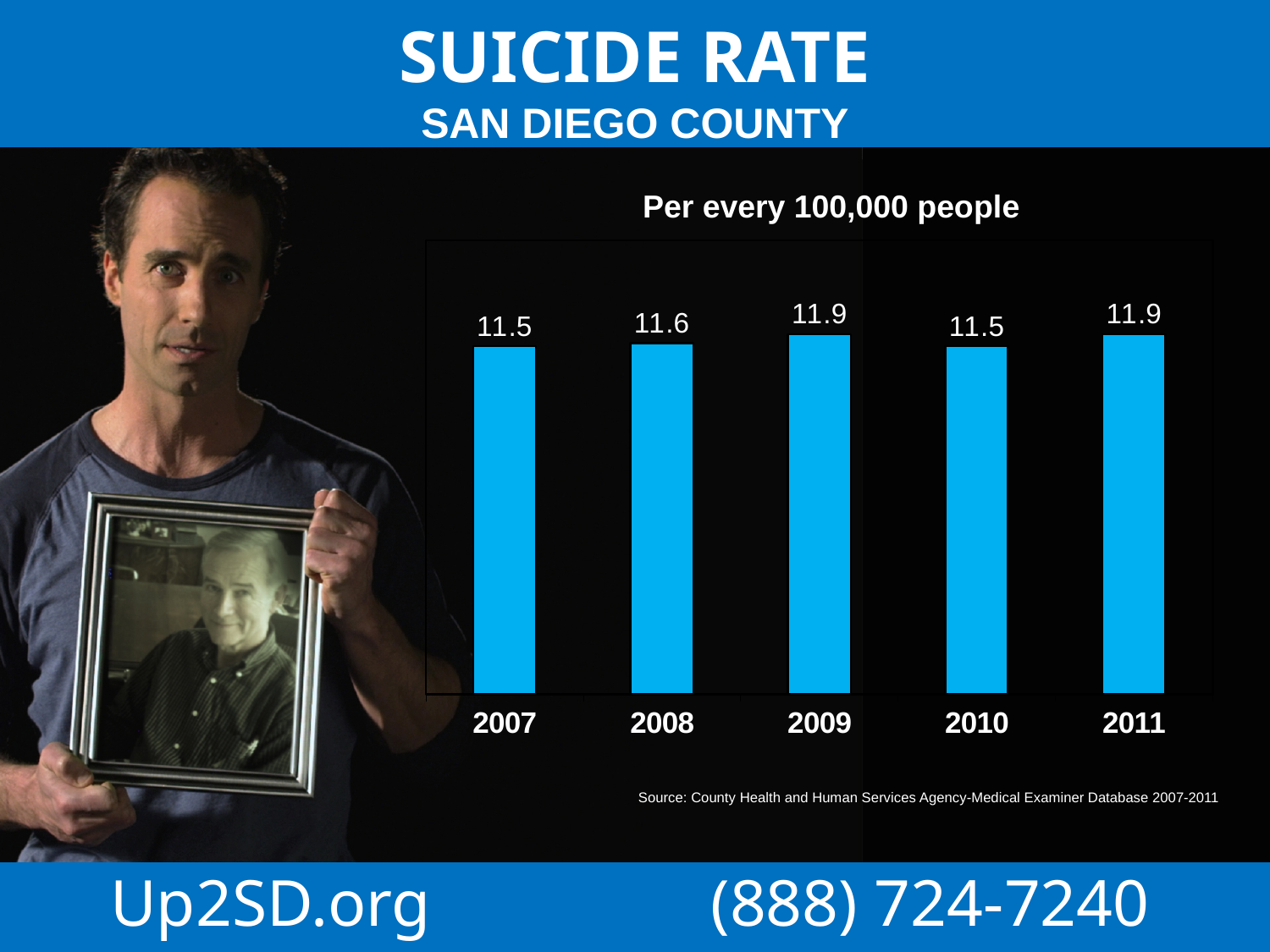
Which years share the lowest suicide rate shown in the chart? 2007 and 2010 What was the suicide rate in San Diego County in 2010? 11.5 How many years are shown in the chart? 5 What is the difference between the suicide rate in 2008 and in 2007? 0.1 What was the suicide rate in San Diego County in 2008? 11.6 What unit is the suicide rate expressed in, according to the chart subtitle? Per every 100,000 people What is the difference between the suicide rate in 2011 and in 2010? 0.4 What was the suicide rate in San Diego County in 2009? 11.9 What kind of chart is shown on the slide? Bar chart What colour are the bars in the chart? Blue What was the suicide rate in San Diego County in 2007? 11.5 Which is larger, the suicide rate in 2009 or in 2010? 2009